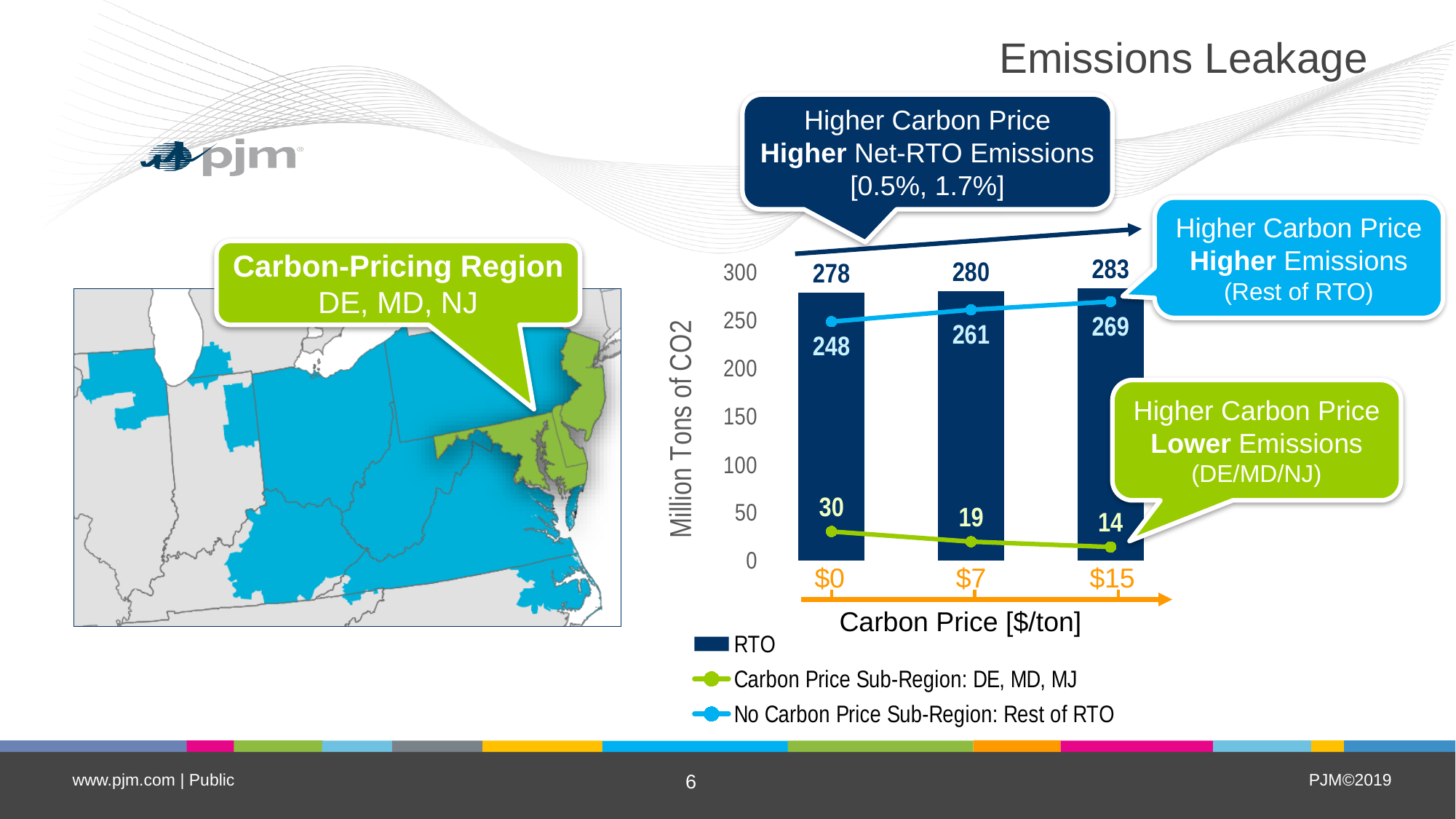
How many series does the legend list? 3 At which carbon price is the RTO emissions value highest? $15 At which carbon price is the Carbon Price Sub-Region: DE, MD, MJ value lowest? $15 What is the label of the y axis? Million Tons of CO2 Is the No Carbon Price Sub-Region value at $7 greater or less than 250? greater What is the difference between the No Carbon Price Sub-Region value at $15 and at $0? 21 How many carbon price levels are shown on the x axis? 3 What is the value for the No Carbon Price Sub-Region: Rest of RTO series at a carbon price of $0? 248 What is the RTO emissions value at a carbon price of $7? 280 Which is larger: the Carbon Price Sub-Region value at $0 or at $7? $0 What is the value for the Carbon Price Sub-Region: DE, MD, MJ series at a carbon price of $15? 14 How does the Carbon Price Sub-Region: DE, MD, MJ series change as the carbon price increases? It falls